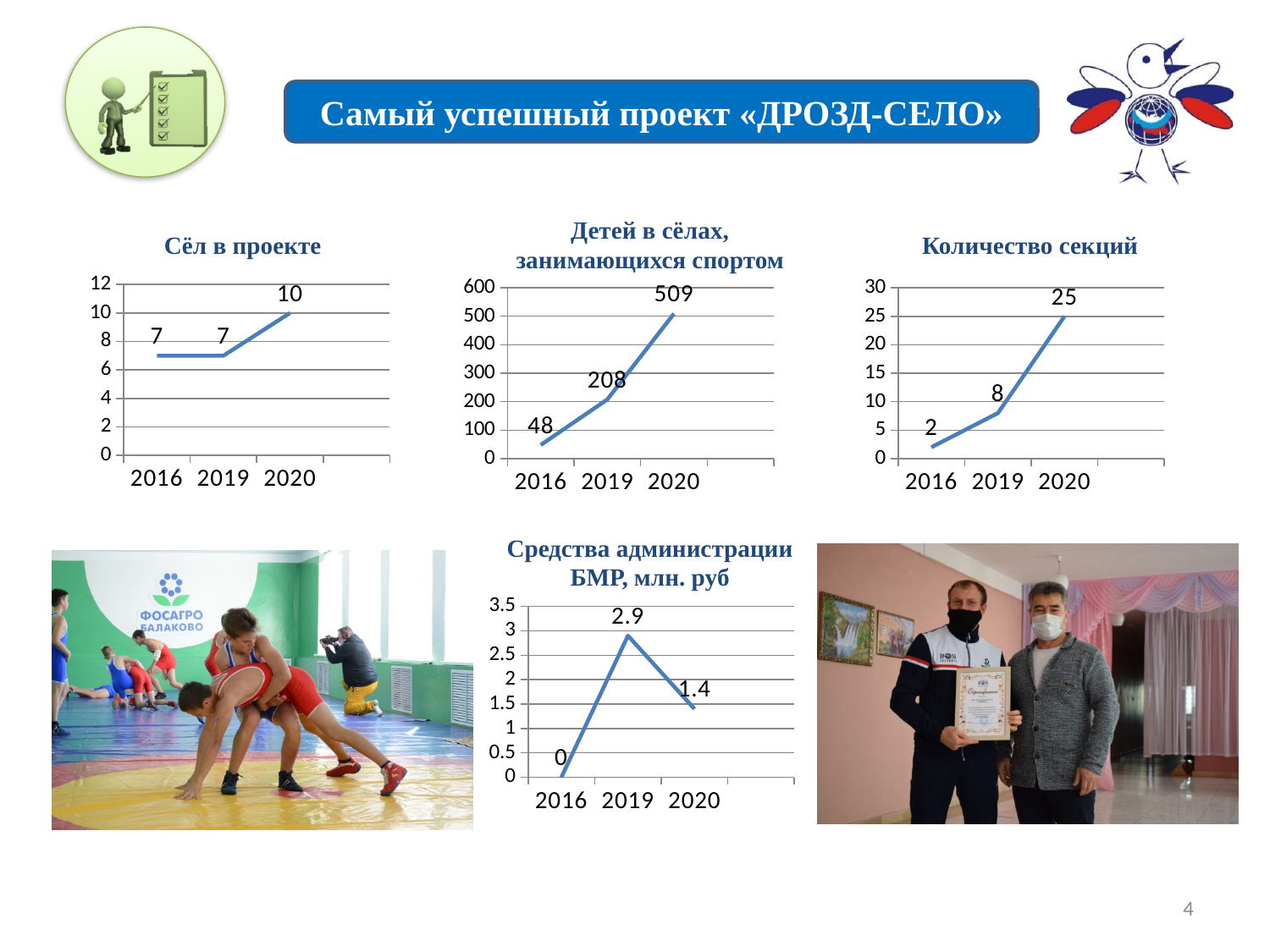
In the chart titled «Количество секций», what is the value for 2016? 2 How many data points are plotted in the chart titled «Сёл в проекте»? 3 In the chart titled «Сёл в проекте», what is the value for 2020? 10 In the chart titled «Детей в сёлах, занимающихся спортом», what is the difference between the values for 2020 and 2016? 461 In the chart titled «Детей в сёлах, занимающихся спортом», what is the value for 2019? 208 In the chart titled «Средства администрации БМР, млн. руб», which is larger, the value for 2019 or the value for 2020? 2019 In the chart titled «Средства администрации БМР, млн. руб», what is the value for 2019? 2.9 What kind of chart is the chart titled «Количество секций»? line chart In the chart titled «Средства администрации БМР, млн. руб», which year has the lowest value? 2016 In the chart titled «Количество секций», what is the difference between the values for 2020 and 2019? 17 In the chart titled «Количество секций», do the values rise or fall from 2016 to 2020? rise In the chart titled «Детей в сёлах, занимающихся спортом», which year has the highest value? 2020